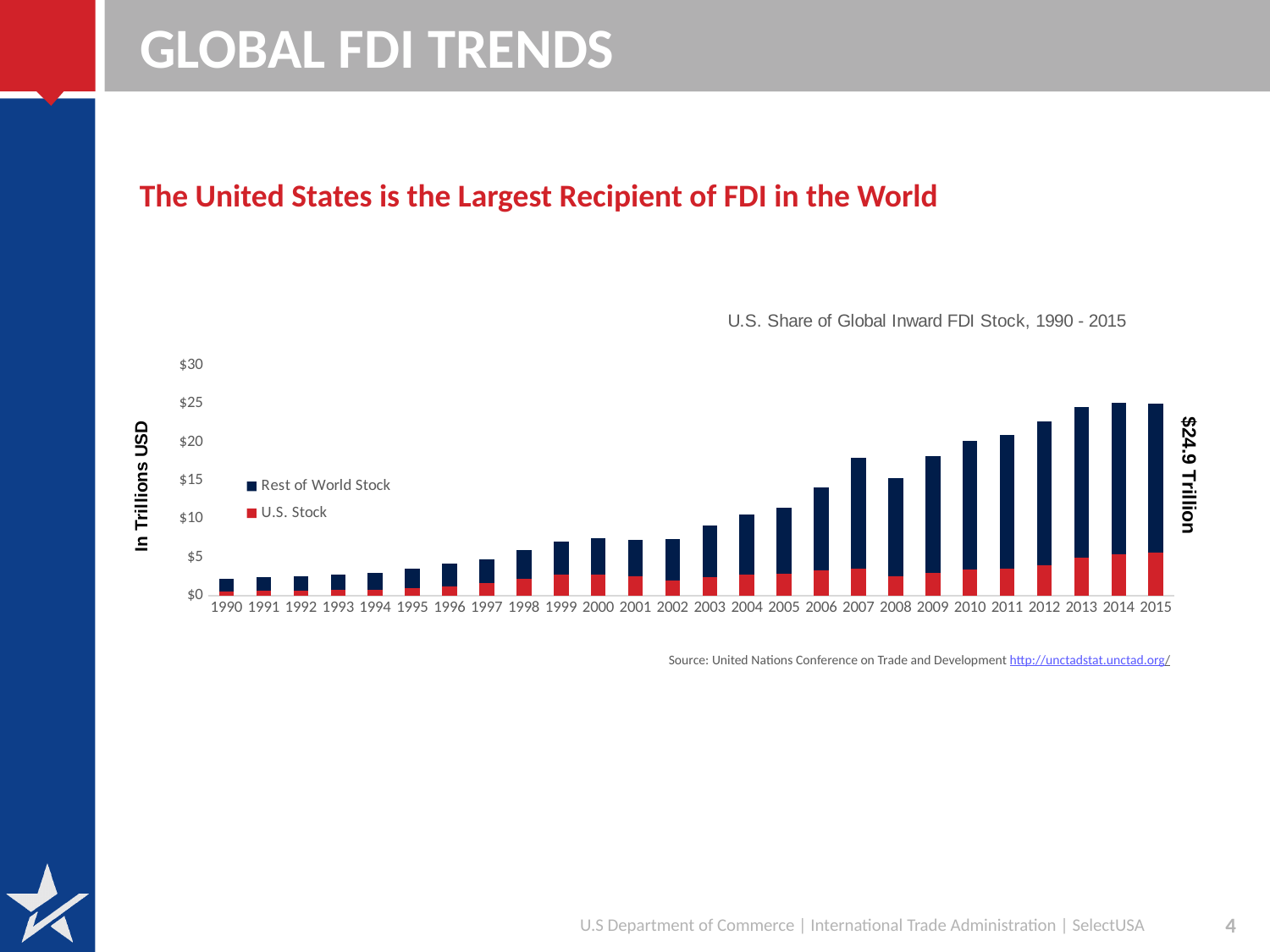
How many years are shown along the x axis? 26 Is the total stacked value for 2000 greater or less than $5? greater Is the total stacked value for 2012 greater or less than $20? greater Do the total stacked bar values generally rise or fall from 1990 to 2015? rise What is the title of the chart? U.S. Share of Global Inward FDI Stock, 1990 - 2015 What kind of chart is shown on the slide? bar chart How many series does the legend list? 2 Which year has the lowest total stacked bar? 1990 Is the total stacked value for 1990 greater or less than $5? less What are the two series named in the legend? Rest of World Stock and U.S. Stock What is the total global inward FDI stock labeled for 2015? $24.9 Trillion Which year has the larger total stacked bar, 2007 or 2008? 2007